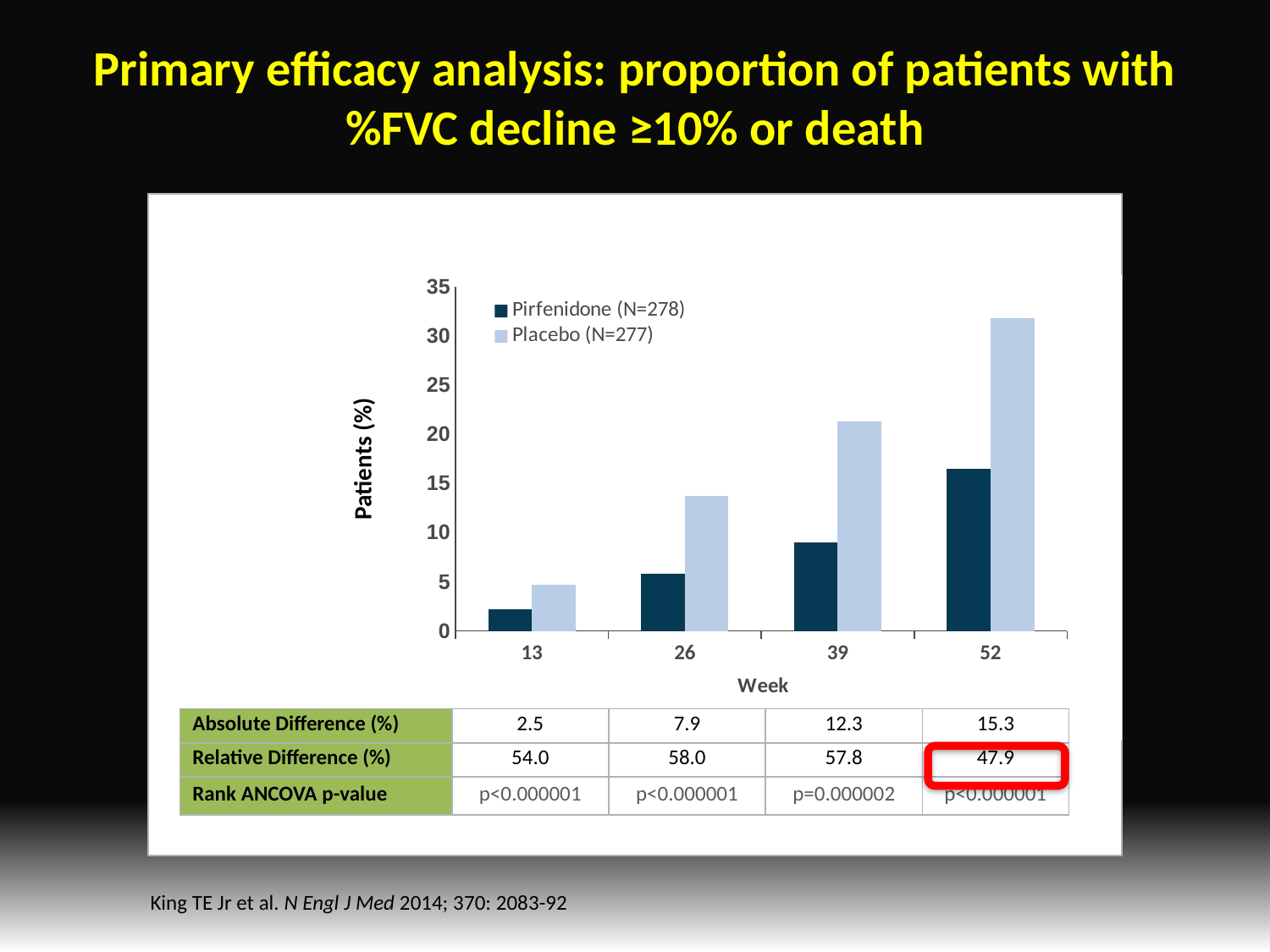
Is the Placebo value at week 39 greater or less than 20? greater At which week is the Pirfenidone value lowest? 13 According to the table below the chart, what is the Absolute Difference (%) at week 52? 15.3 At week 52, which series has the larger value, Pirfenidone or Placebo? Placebo How many series does the legend list? 2 At which week is the Placebo value highest? 52 What kind of chart is shown on the slide? bar chart What is the label of the y axis? Patients (%) Do the Pirfenidone values rise or fall from week 13 to week 52? rise Is the Pirfenidone value at week 52 greater or less than 15? greater How many week categories are shown on the x axis? 4 Is the Placebo value at week 52 greater or less than 30? greater